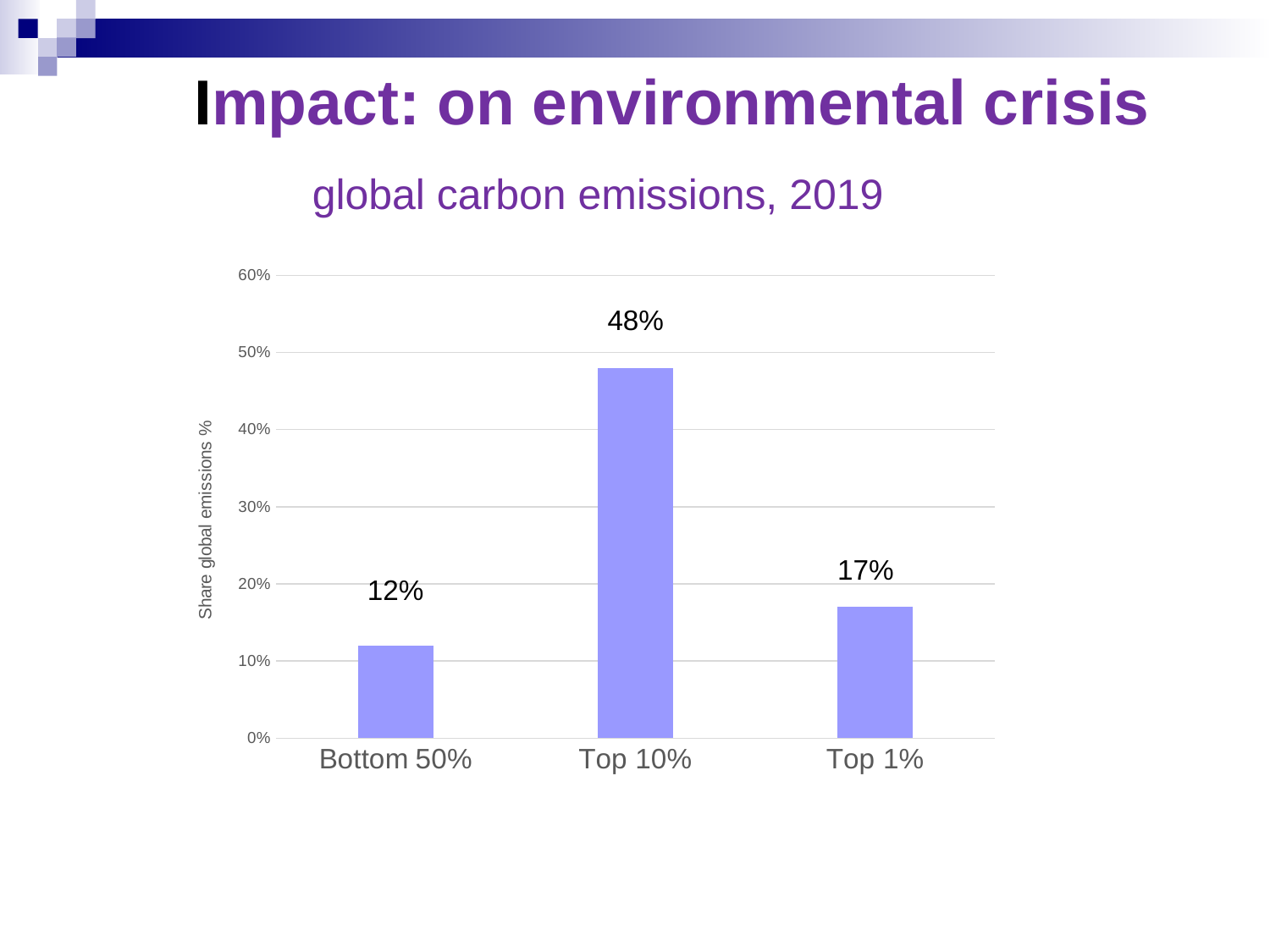
Is the value for the Top 10% greater or less than 40%? greater What is the share of global carbon emissions for the Top 1%? 17% Which has a larger share of global emissions, the Top 1% or the Bottom 50%? Top 1% Which category has the lowest share of global emissions? Bottom 50% What is the difference between the share for the Top 1% and the share for the Bottom 50%? 5% What is the difference between the share for the Top 10% and the share for the Bottom 50%? 36% What is the share of global carbon emissions for the Bottom 50%? 12% How many categories are shown on the x axis? 3 What is the label of the vertical axis? Share global emissions % What is the share of global carbon emissions for the Top 10%? 48% What kind of chart is shown on the slide? Bar chart Which category has the highest share of global emissions? Top 10%